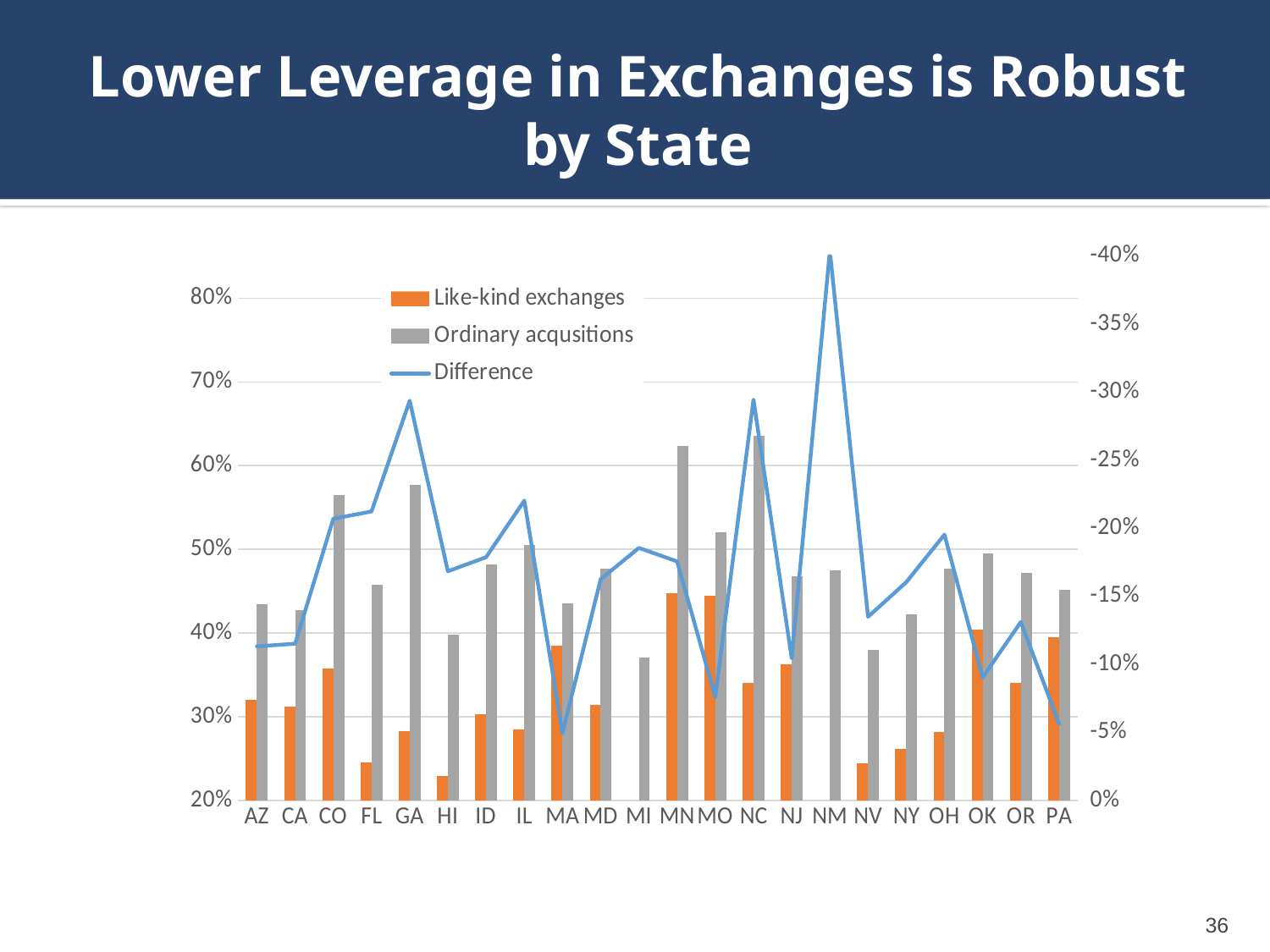
How many series does the chart legend list? 3 Is the Like-kind exchanges value for MN greater or less than 40%? greater Is the Ordinary acquisitions value for NC greater or less than 60%? greater Which is larger, the Like-kind exchanges value for OK or for OR? OK What kind of chart is shown on the slide? Bar chart with a line series Is the Like-kind exchanges value for HI greater or less than 30%? less Which is larger, the Ordinary acquisitions value for CO or for FL? CO How many states are shown on the x axis of the chart? 22 What colour are the Like-kind exchanges bars? Orange